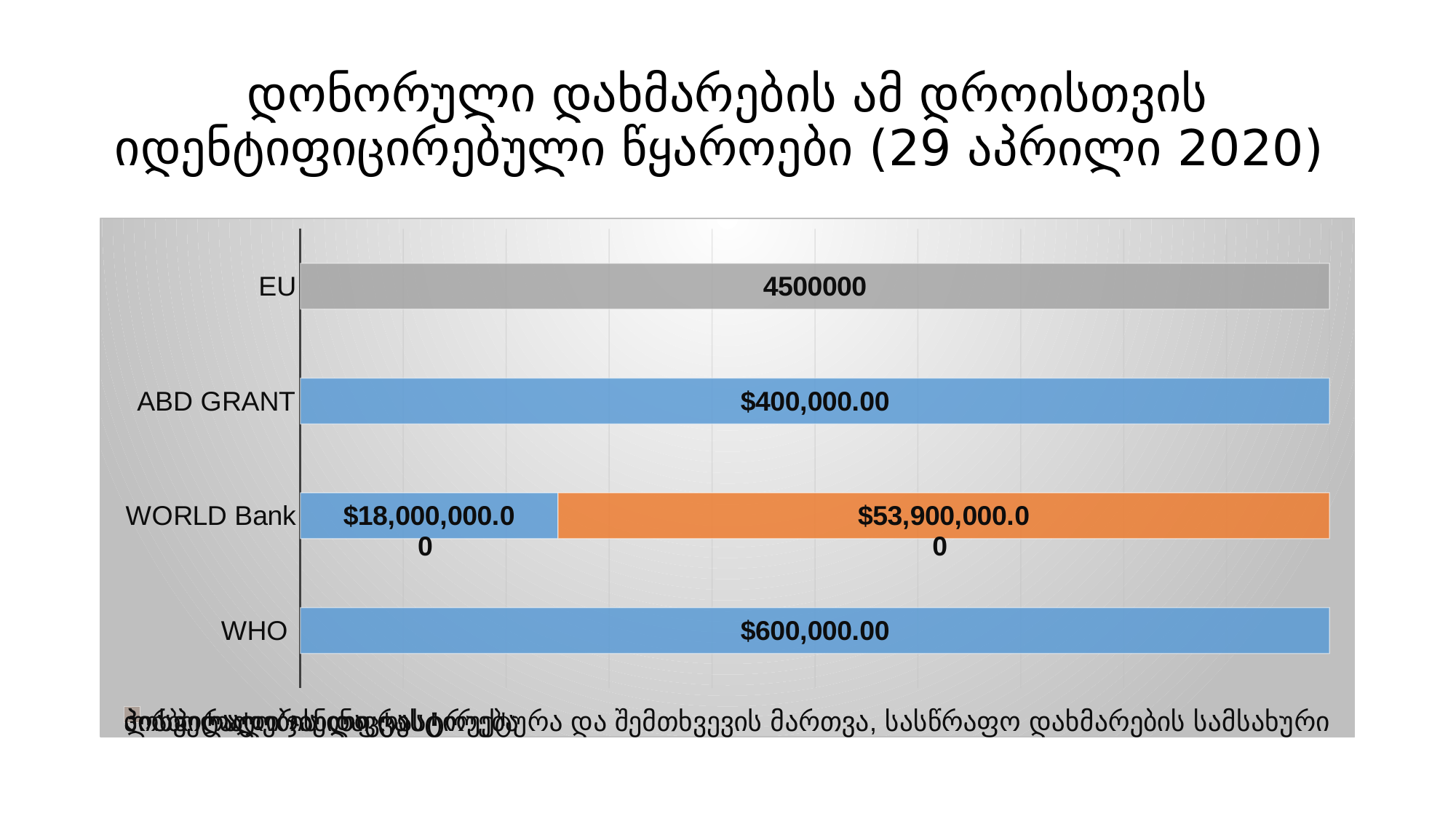
Which category has the smallest labelled value? ABD GRANT What value is shown for ABD GRANT? $400,000.00 What is the value of the orange (second) segment of the WORLD Bank bar? $53,900,000.00 What kind of chart is shown on the slide? Bar chart Which category has the largest total value? WORLD Bank What is the value of the blue (first) segment of the WORLD Bank bar? $18,000,000.00 What is the difference between the two segments of the WORLD Bank bar? $35,900,000.00 How many categories are shown on the chart? 4 What is the total of the two segments of the WORLD Bank bar? $71,900,000.00 What value is shown for WHO? $600,000.00 What value is shown for EU? 4500000 Which is larger, the value for WHO or the value for ABD GRANT? WHO